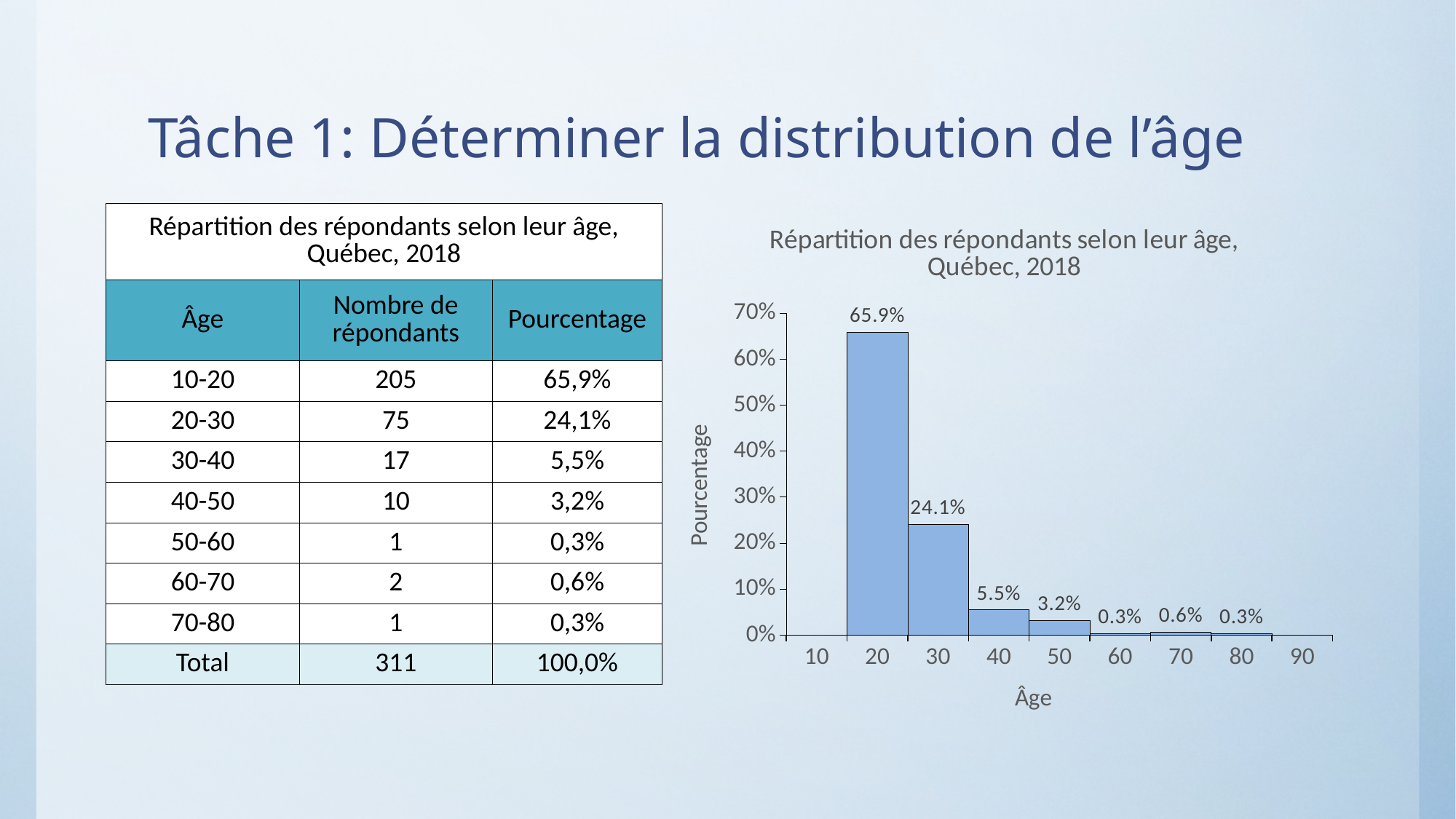
What is the title of the chart? Répartition des répondants selon leur âge, Québec, 2018 What percentage does the chart show for the 60-70 age group? 0.6% What is the label of the vertical axis of the chart? Pourcentage What percentage does the chart show for the 30-40 age group? 5.5% What type of chart is shown on the slide? bar chart Do the percentages rise or fall as age increases from 10-20 to 50-60? fall What percentage does the chart show for the 10-20 age group? 65.9% What percentage does the chart show for the 20-30 age group? 24.1% Which age group has the highest percentage in the chart? 10-20 What is the difference in percentage between the 10-20 and 20-30 age groups? 41.8% How many age-group bars are plotted in the chart? 7 Which has a larger percentage, the 30-40 age group or the 40-50 age group? 30-40